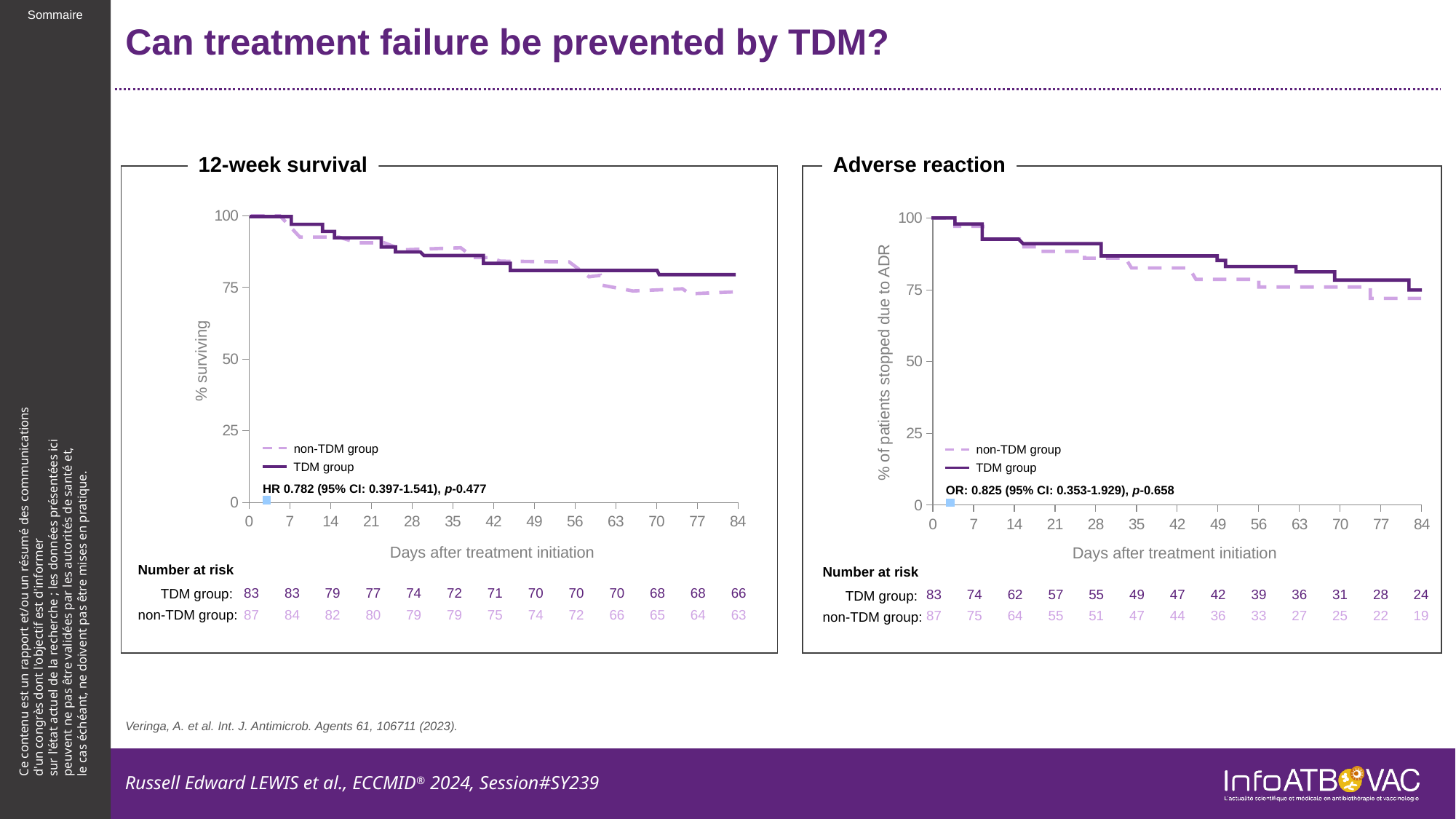
On the 12-week survival chart, what is the difference between the number at risk for the TDM group and the non-TDM group at day 84? 3 On the 12-week survival chart, what is the number at risk for the TDM group at day 0? 83 On the 12-week survival chart, do the curves rise or fall as days after treatment initiation increase? fall On the 12-week survival chart, what kind of chart is shown? line chart On the Adverse reaction chart, what is the number at risk for the non-TDM group at day 42? 44 On the 12-week survival chart, what is the number at risk for the non-TDM group at day 84? 63 On the Adverse reaction chart, is the value for the non-TDM group at day 84 greater or less than 50? greater On the Adverse reaction chart, what odds ratio (OR) is reported? 0.825 On the Adverse reaction chart, which group has the larger number at risk at day 84, the TDM group or the non-TDM group? TDM group On the 12-week survival chart, is the value for the TDM group at day 84 greater or less than 75? greater On the Adverse reaction chart, what is the number at risk for the TDM group at day 84? 24 On the 12-week survival chart, how many series does the legend list? 2